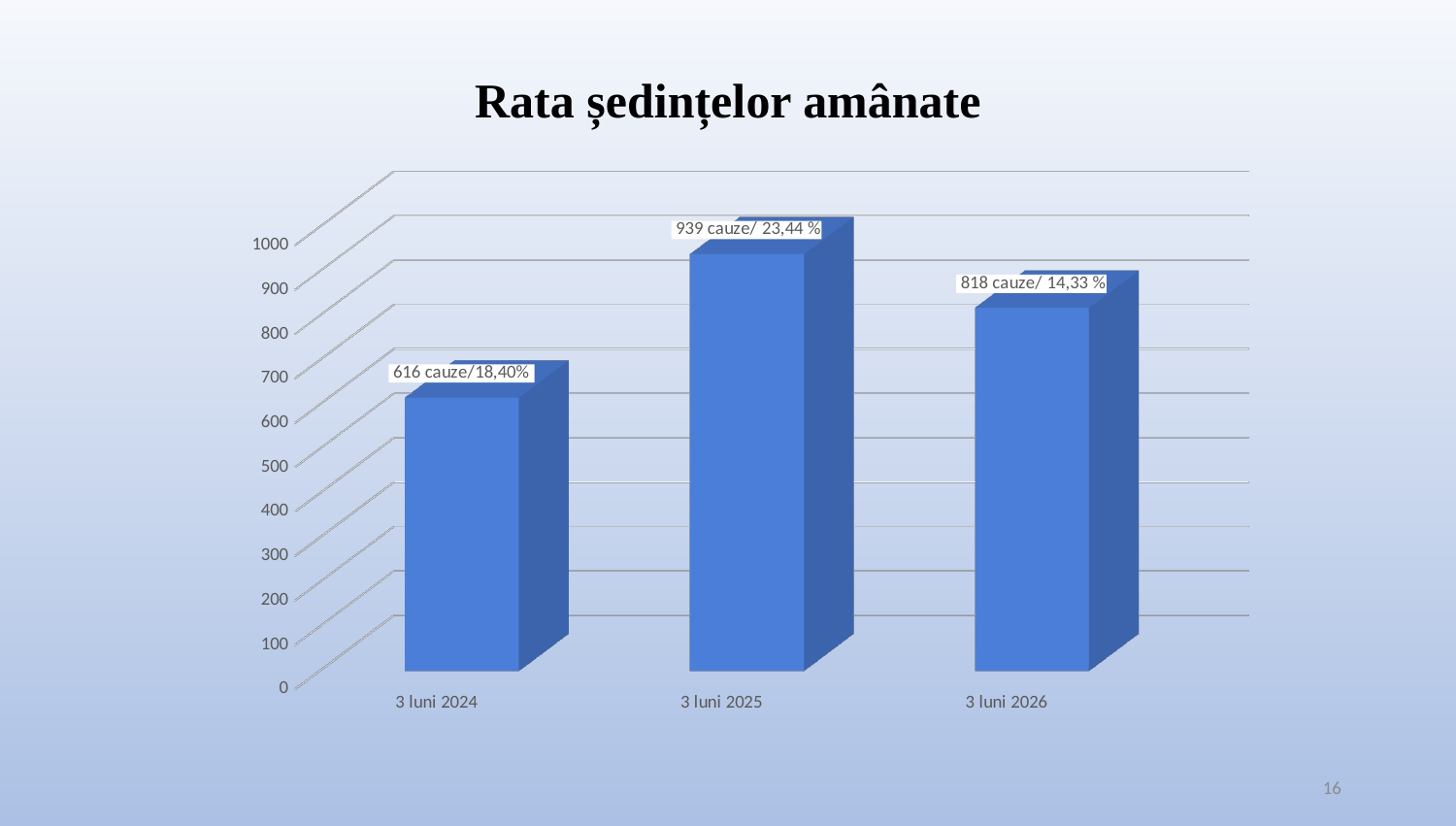
What is the title of the chart? Rata ședințelor amânate How many categories are shown on the x axis? 3 Which has more cases, 3 luni 2026 or 3 luni 2024? 3 luni 2026 Is the number of cases for 3 luni 2026 greater or less than 900? less How many cases (cauze) are shown for 3 luni 2025? 939 What is the data label shown for 3 luni 2024? 616 cauze/18,40% Which category has the highest number of cases? 3 luni 2025 Which category has the lowest number of cases? 3 luni 2024 What is the difference in the number of cases between 3 luni 2025 and 3 luni 2024? 323 What percentage is shown in the data label for 3 luni 2026? 14,33 % What is the difference in the number of cases between 3 luni 2025 and 3 luni 2026? 121 What kind of chart is shown on the slide? bar chart